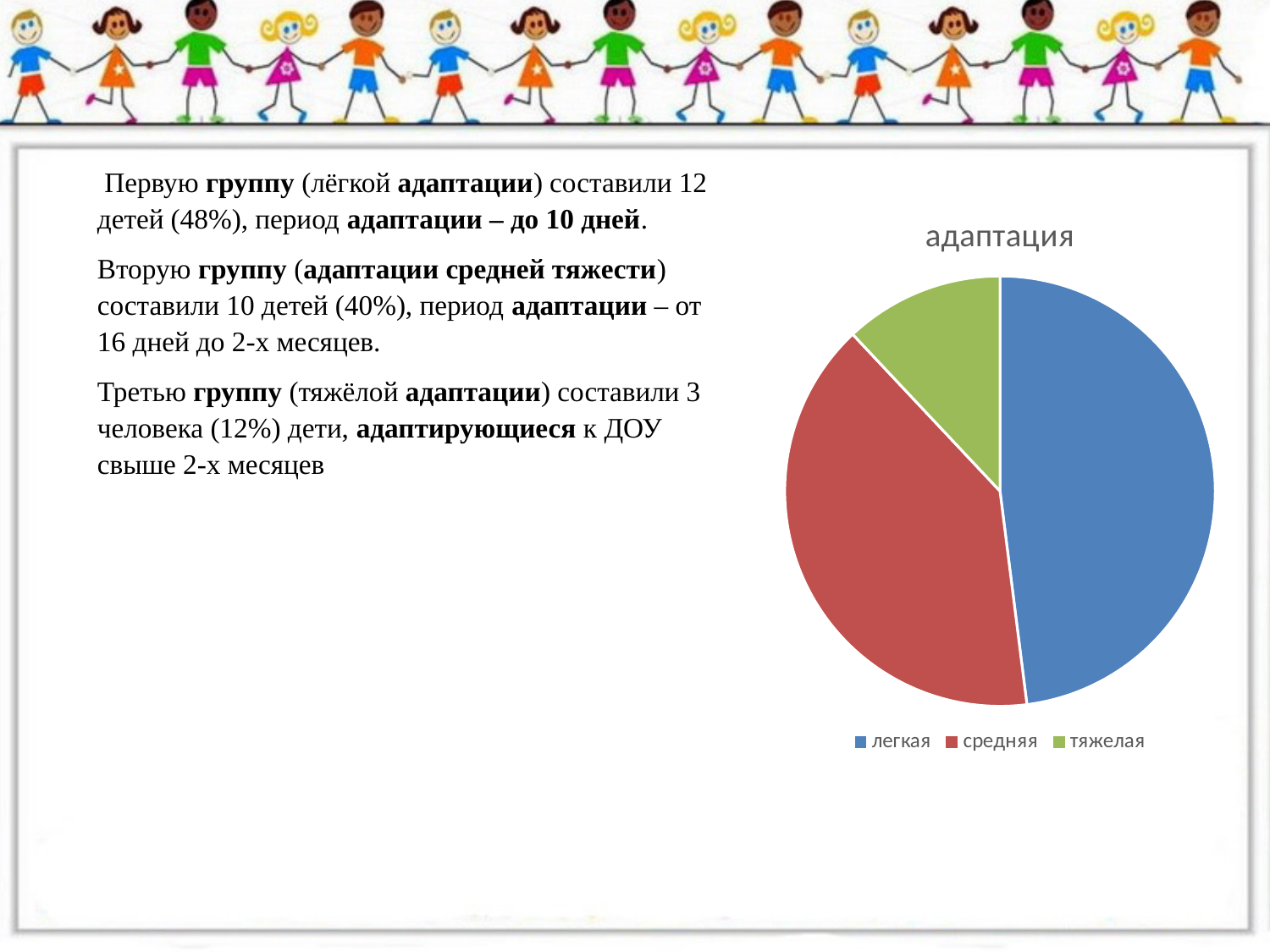
How many entries does the chart legend list? 3 What colour is the slice for средняя? red What kind of chart is shown on the slide? pie chart Which slice is larger, средняя or тяжелая? средняя What share of the pie does the средняя slice represent, according to the slide text? 40% What share of the pie does the легкая slice represent, according to the slide text? 48% Which category has the largest slice of the pie? легкая How many slices does the pie chart have? 3 What is the title of the chart? адаптация What share of the pie does the тяжелая slice represent, according to the slide text? 12% Which category has the smallest slice of the pie? тяжелая Which slice is larger, легкая or тяжелая? легкая